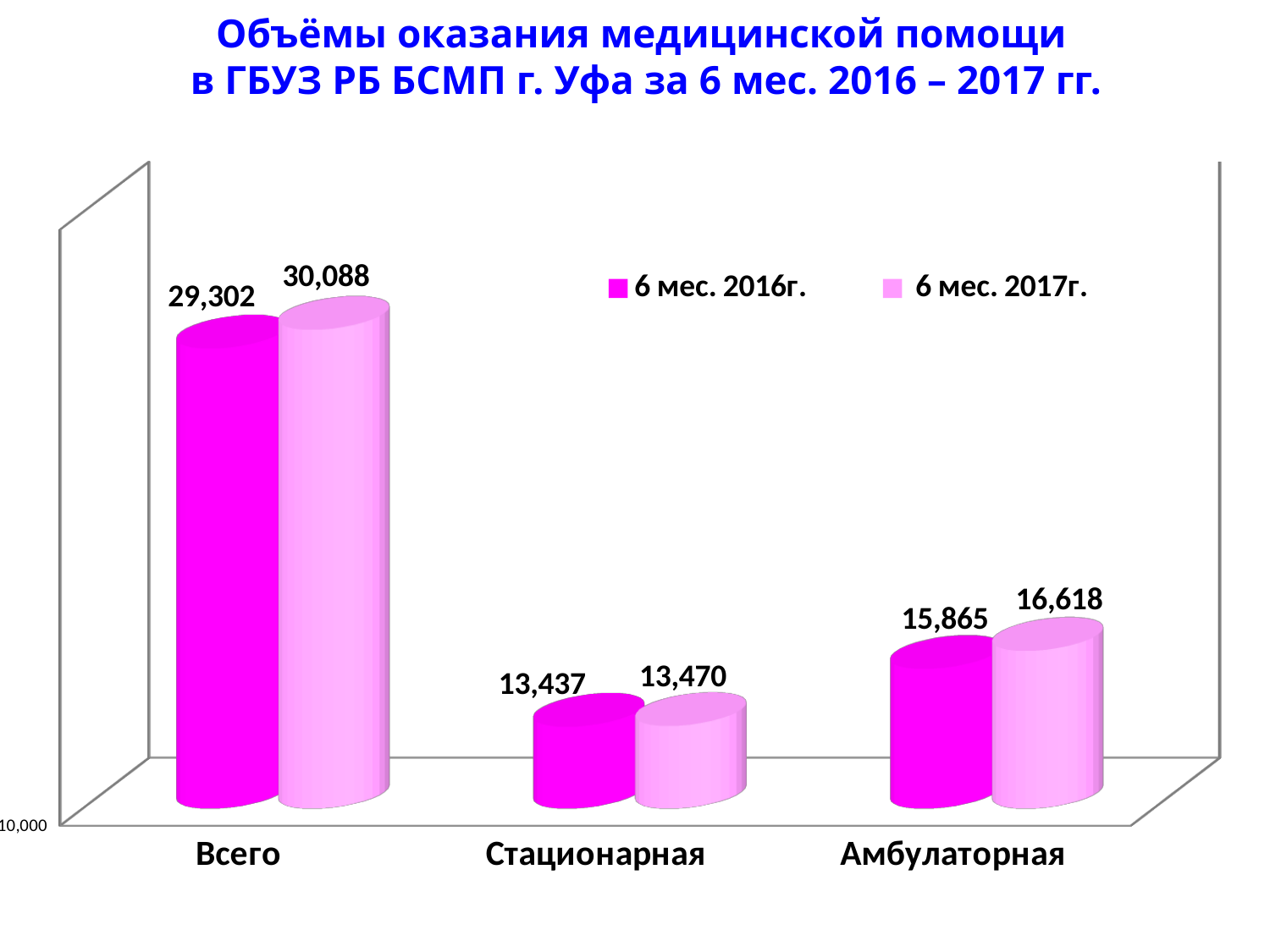
What is the difference between the 6 мес. 2017г. and 6 мес. 2016г. values for Всего? 786 Which category has the highest value in the 6 мес. 2016г. series? Всего What is the difference between the 6 мес. 2017г. and 6 мес. 2016г. values for Амбулаторная? 753 How many series does the legend list? 2 What kind of chart is shown on the slide? Bar chart Which is larger for Амбулаторная: the 6 мес. 2016г. value or the 6 мес. 2017г. value? 6 мес. 2017г. What is the value for Амбулаторная in the 6 мес. 2017г. series? 16,618 Which category has the lowest value in the 6 мес. 2017г. series? Стационарная What is the value for Всего in the 6 мес. 2016г. series? 29,302 How many categories are shown on the x axis? 3 What is the value for Всего in the 6 мес. 2017г. series? 30,088 What is the value for Стационарная in the 6 мес. 2016г. series? 13,437